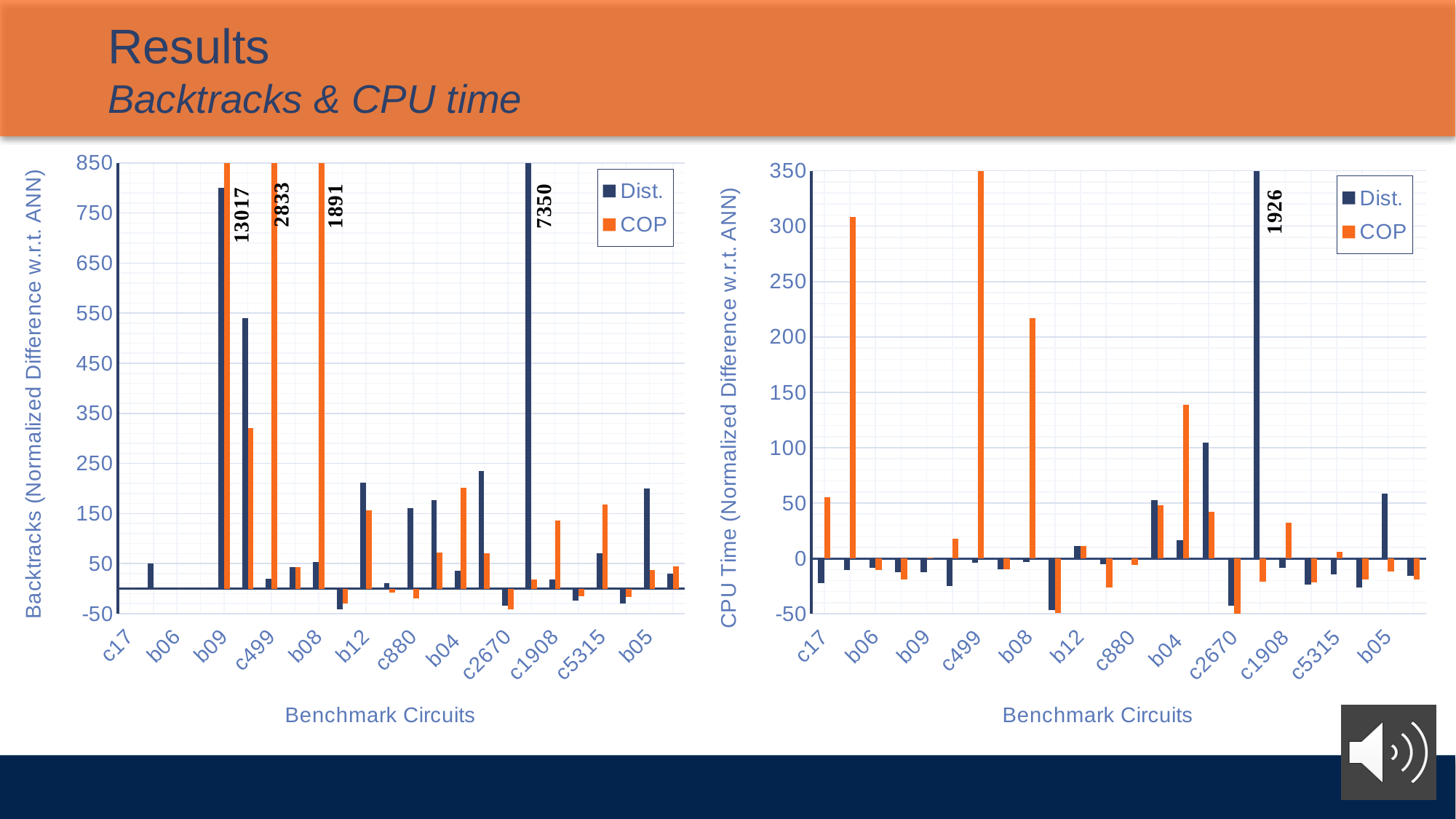
How many series does the legend of the CPU Time chart list? 2 How many data labels are printed on the Backtracks chart? 4 What kind of chart is the Backtracks chart on the left? bar chart In the Backtracks chart, what is the largest value printed as a data label? 13017 In the CPU Time chart, what value is printed on the Dist. bar that extends above the top of the axis? 1926 What are the two legend entries in the Backtracks chart? Dist. and COP In the CPU Time chart, is the COP value for b06 greater or less than 250? less In the Backtracks chart, what is the smallest value printed as a data label? 1891 What is the y-axis title of the right-hand chart? CPU Time (Normalized Difference w.r.t. ANN) In the Backtracks chart, is the Dist. value for c17 greater or less than 150? less In the CPU Time chart, is the COP value for c17 greater or less than 100? less